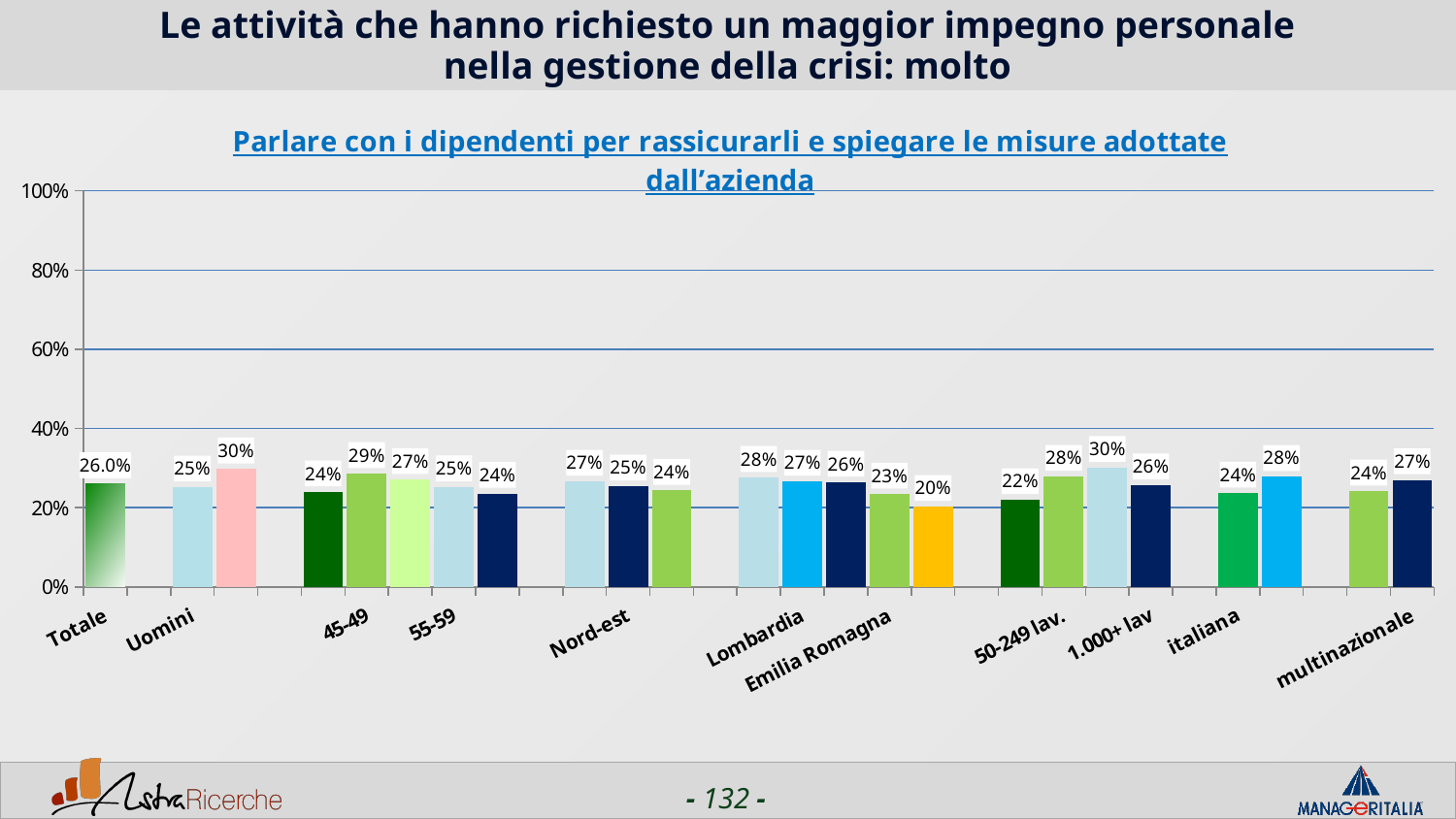
What is the value for 55-59? 25% Is the value for Totale greater or less than 40%? less What is the value for Uomini? 25% What is the subtitle shown above the chart? Parlare con i dipendenti per rassicurarli e spiegare le misure adottate dall'azienda What is the difference between the values for Lombardia and Emilia Romagna? 4 percentage points Which is larger, the value for 45-49 or the value for 55-59? 45-49 What is the value for 50-249 lav.? 28% What is the value for Lombardia? 27% What is the value for 45-49? 29% What kind of chart is shown on the slide? bar chart What is the value for Totale? 26.0% What is the value for Emilia Romagna? 23%